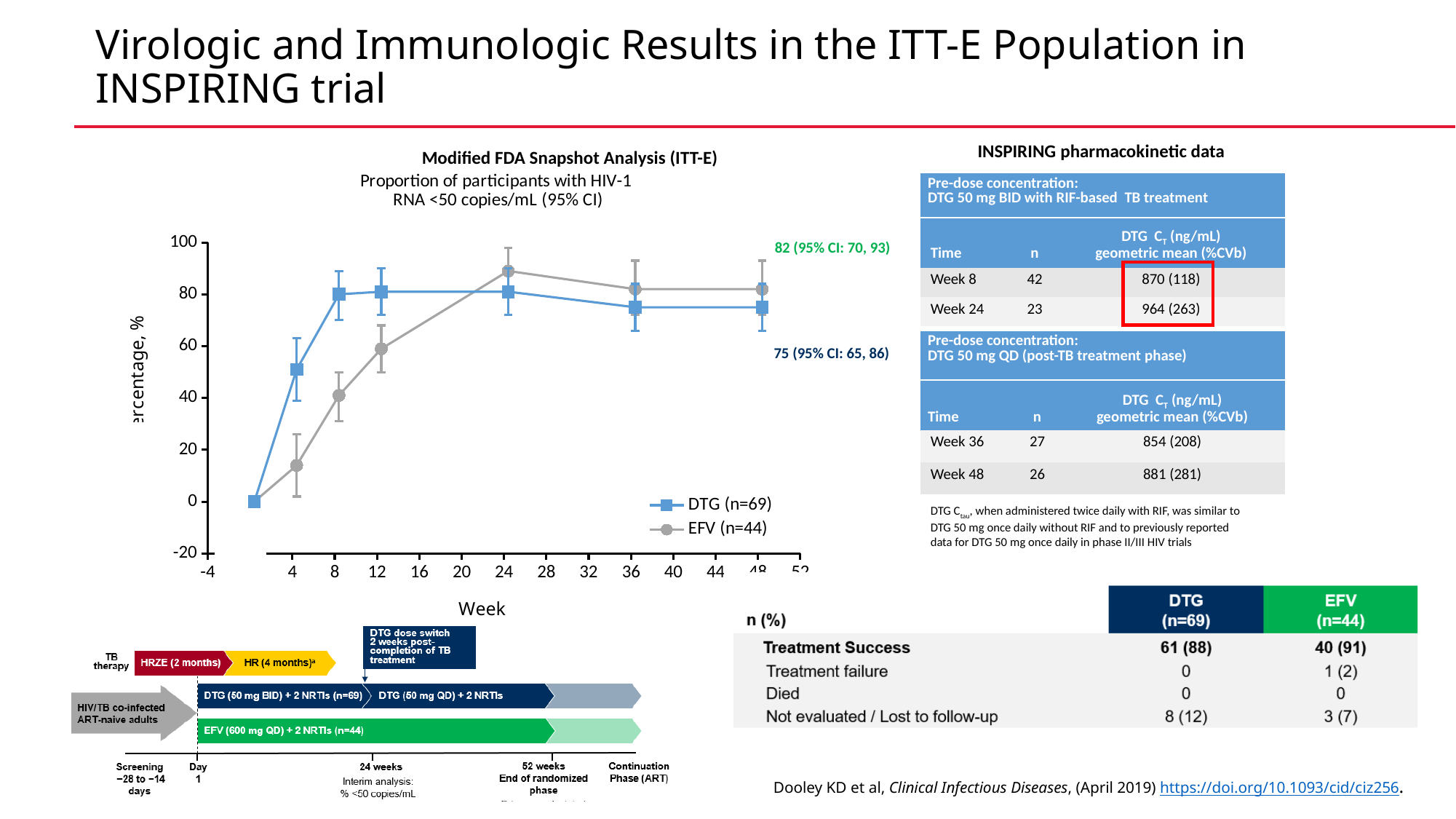
In the Modified FDA Snapshot Analysis chart, which series has the higher percentage at week 48, DTG or EFV? EFV In the Modified FDA Snapshot Analysis chart, is the value for EFV at week 12 greater or less than 80? less How many series does the legend of the Modified FDA Snapshot Analysis chart list? 2 In the Modified FDA Snapshot Analysis chart, is the value for DTG at week 4 greater or less than 40? greater What is the x-axis label of the Modified FDA Snapshot Analysis chart? Week In the Modified FDA Snapshot Analysis chart, what is the percentage for EFV (n=44) at week 48? 82 In the Modified FDA Snapshot Analysis chart, what is the percentage for DTG (n=69) at week 48? 75 In the Modified FDA Snapshot Analysis chart, which series has the higher percentage at week 12, DTG or EFV? DTG In the Modified FDA Snapshot Analysis chart, does the DTG line rise or fall between week 0 and week 8? rise In the Modified FDA Snapshot Analysis chart, what is the difference between the EFV and DTG percentages at week 48? 7 In the Modified FDA Snapshot Analysis chart, is the value for EFV at week 4 greater or less than 20? less What kind of chart is the Modified FDA Snapshot Analysis chart? line chart